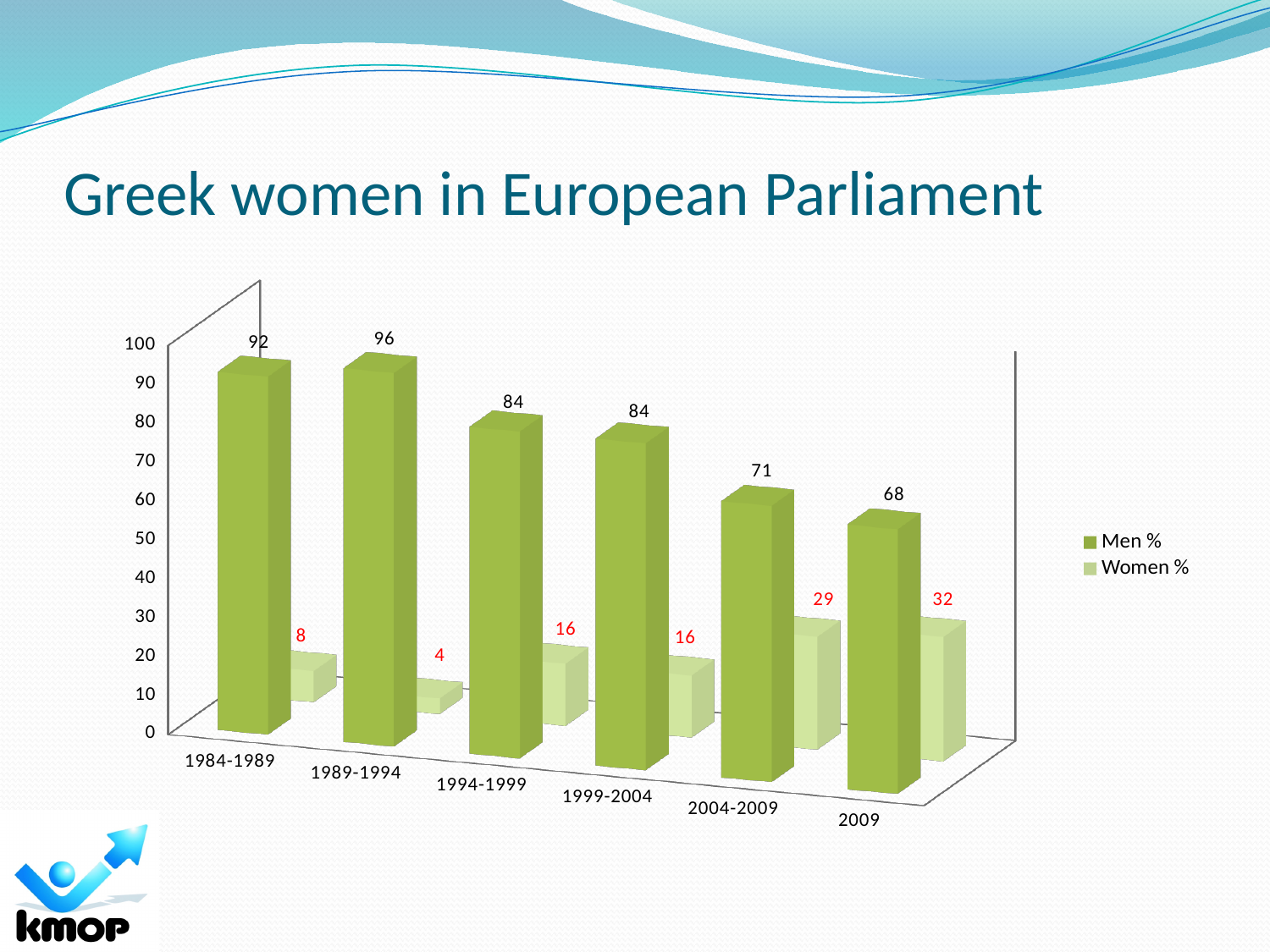
How many series does the legend list? 2 Which period has the lowest Women % value? 1989-1994 What is the difference between the Men % and Women % values for 2004-2009? 42 What is the Men % value for 1984-1989? 92 Is the Women % value for 2004-2009 larger or smaller than the Women % value for 1999-2004? larger Which period has the highest Men % value? 1989-1994 What kind of chart is shown on the slide? bar chart What is the Women % value for 2009? 32 How many periods are shown on the x axis? 6 Does the Men % series generally rise or fall from 1989-1994 to 2009? fall What is the title of the slide? Greek women in European Parliament What is the Women % value for 1989-1994? 4